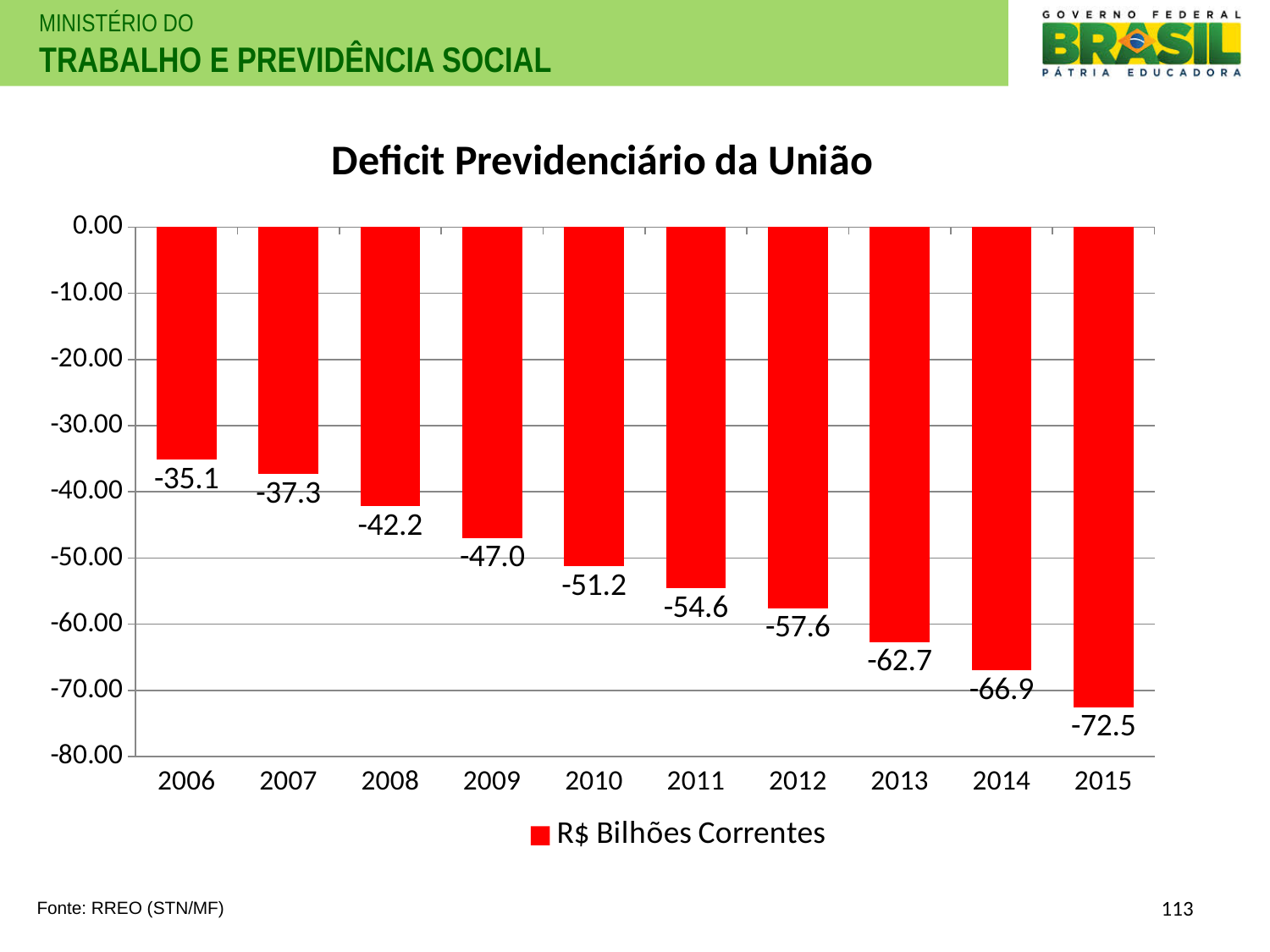
Is the value for 2013 greater or less than -60.00? less Which is larger in magnitude, the value for 2012 or the value for 2009? 2012 What kind of chart is this? bar chart What is the value for 2015? -72.5 How many years are shown on the x axis? 10 What is the value for 2006? -35.1 Which year has the lowest (most negative) value? 2015 Which year has the highest (least negative) value? 2006 Do the values rise or fall from 2006 to 2015? fall What is the difference between the values for 2015 and 2006? 37.4 What is the value for 2010? -51.2 How many series does the legend list? 1